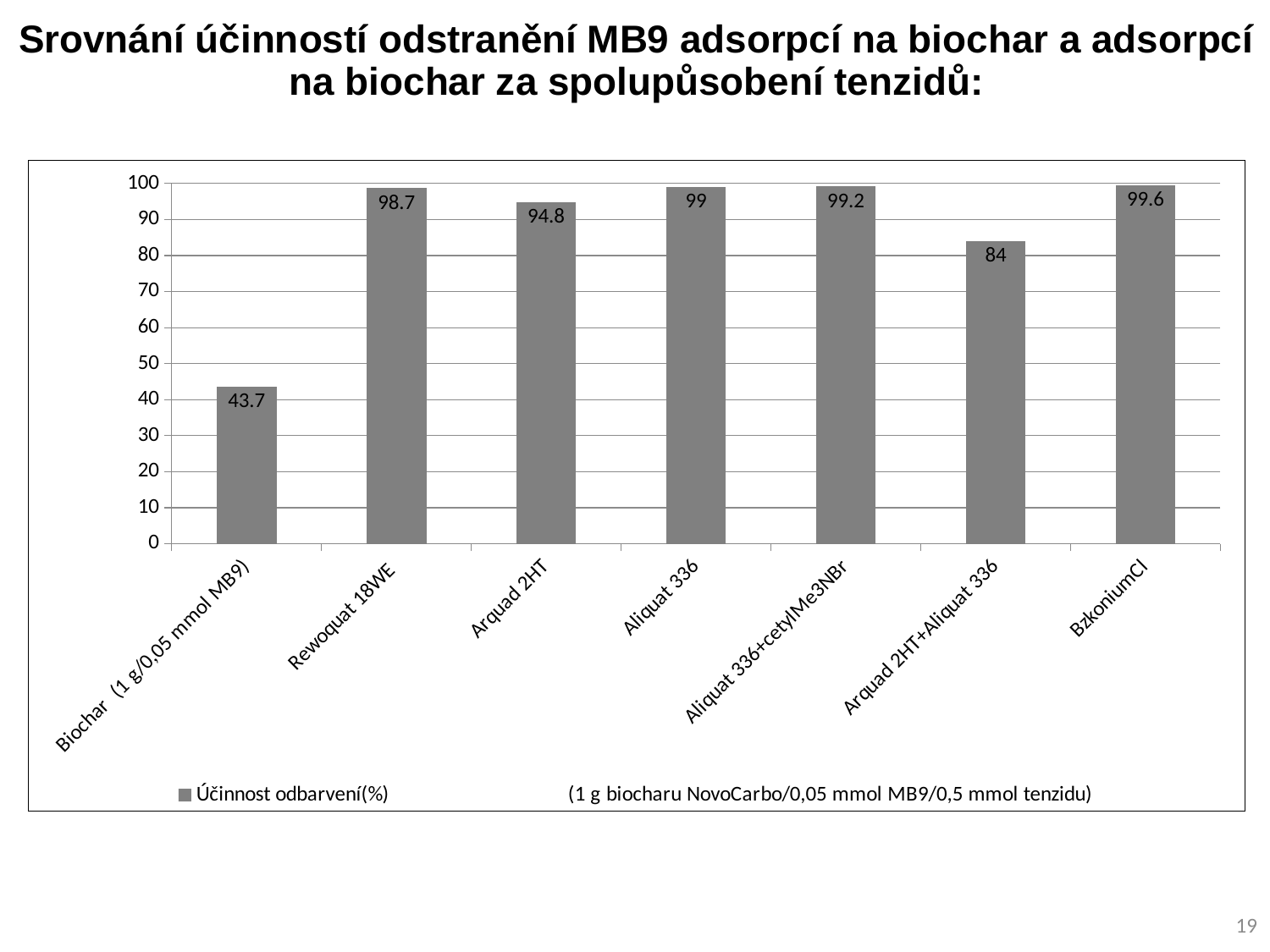
What is the difference between the values for Aliquat 336 and Arquad 2HT? 4.2 How many categories are shown on the x axis? 7 What is the name of the series in the legend? Účinnost odbarvení(%) (1 g biocharu NovoCarbo/0,05 mmol MB9/0,5 mmol tenzidu) What kind of chart is shown on the slide? bar chart Which category has the highest value? BzkoniumCl What is the value for Rewoquat 18WE? 98.7 What is the value for Biochar (1 g/0,05 mmol MB9)? 43.7 Which is larger, the value for Arquad 2HT or the value for Arquad 2HT+Aliquat 336? Arquad 2HT Is the value for Biochar (1 g/0,05 mmol MB9) greater or less than 50? less How many series does the legend list? 1 What is the value for Arquad 2HT+Aliquat 336? 84 Which category has the lowest value? Biochar (1 g/0,05 mmol MB9)